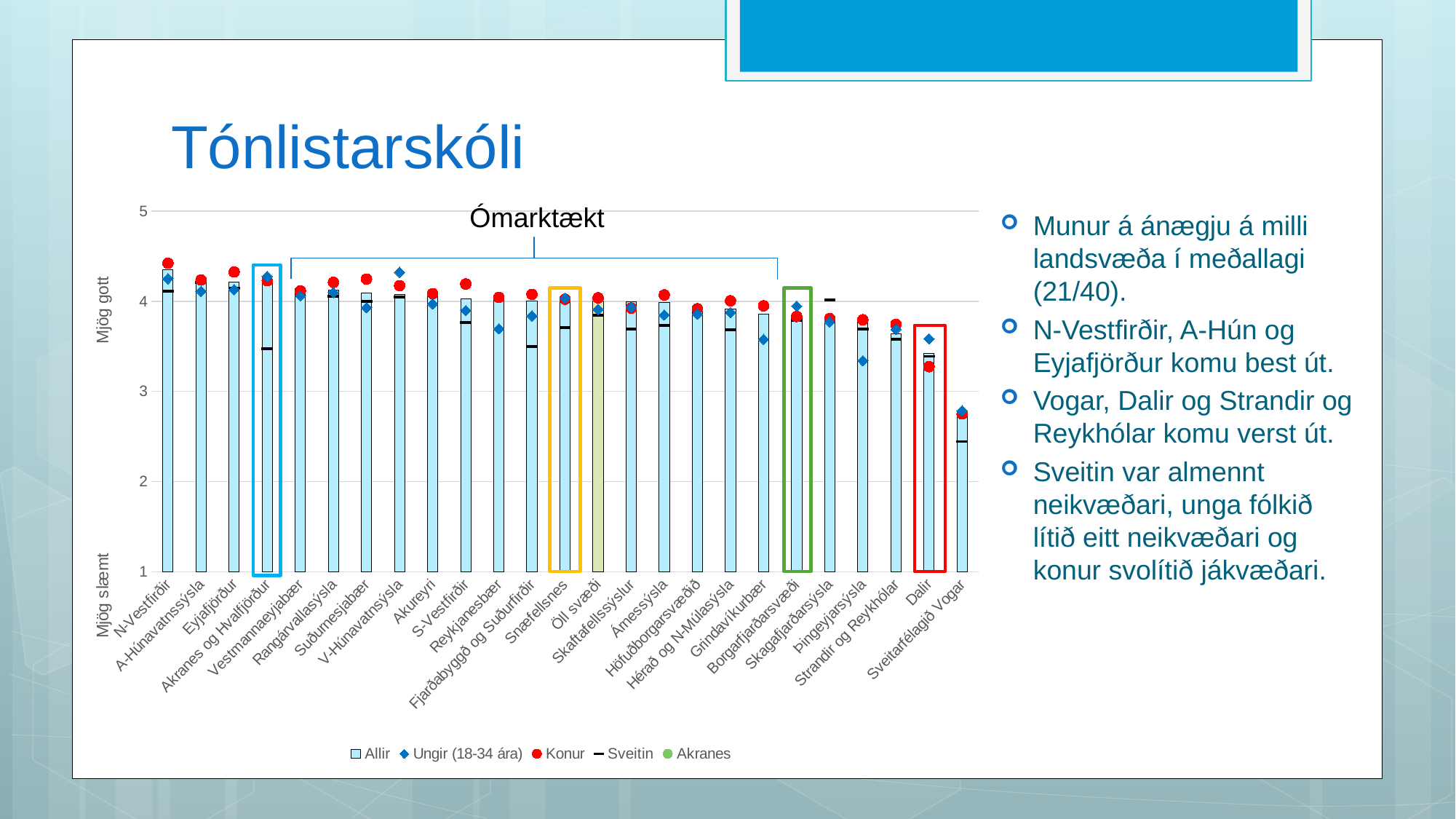
Is the Allir value for Sveitarfélagið Vogar greater or less than 3? less How many categories (regions) are shown along the x axis of the chart? 25 Which has the larger Allir value, Dalir or Sveitarfélagið Vogar? Dalir What is the title of the slide containing the chart? Tónlistarskóli Is the Konur value for N-Vestfirðir greater or less than 4? greater What label is written above the bracket spanning the middle categories of the chart? Ómarktækt Which category has the lowest Allir bar in the chart? Sveitarfélagið Vogar What kind of chart is shown on the slide? bar chart Do the Allir bar values generally rise or fall from left to right along the x axis? fall Is the Allir value for Dalir greater or less than 4? less How many series does the chart legend list? 5